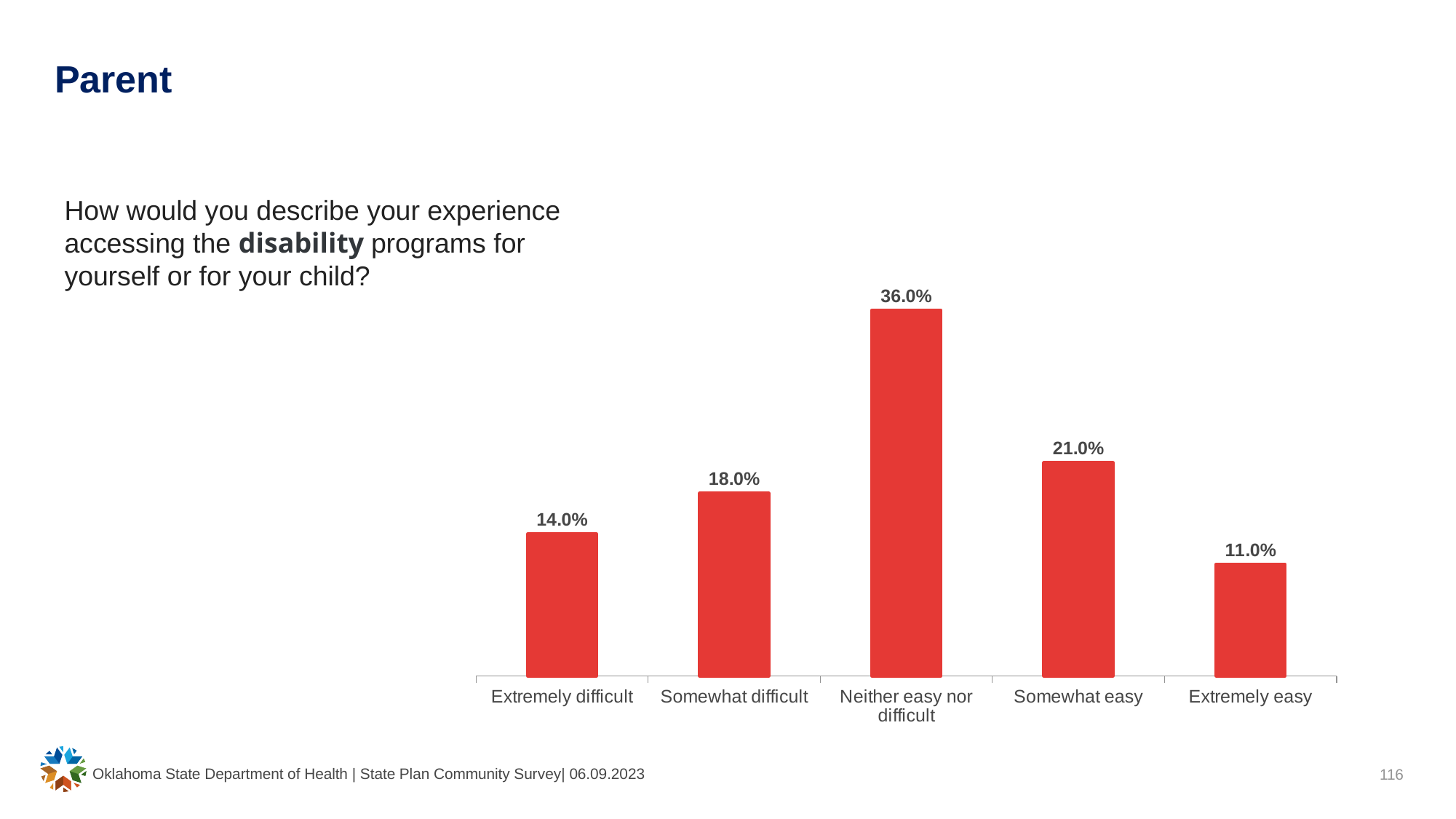
What is the difference between the values for 'Neither easy nor difficult' and 'Somewhat easy'? 15.0% Which response category has the lowest value? Extremely easy What kind of chart is shown on the slide? Bar chart What is the value shown for 'Extremely easy'? 11.0% Which is larger, the value for 'Somewhat difficult' or the value for 'Somewhat easy'? Somewhat easy What is the difference between the values for 'Somewhat difficult' and 'Extremely difficult'? 4.0% What is the value shown for 'Somewhat easy'? 21.0% How many response categories are shown on the chart? 5 What colour are the bars in the chart? Red What is the value shown for 'Extremely difficult'? 14.0% What percentage of parents described their experience accessing disability programs as 'Neither easy nor difficult'? 36.0% Which response category has the highest value? Neither easy nor difficult